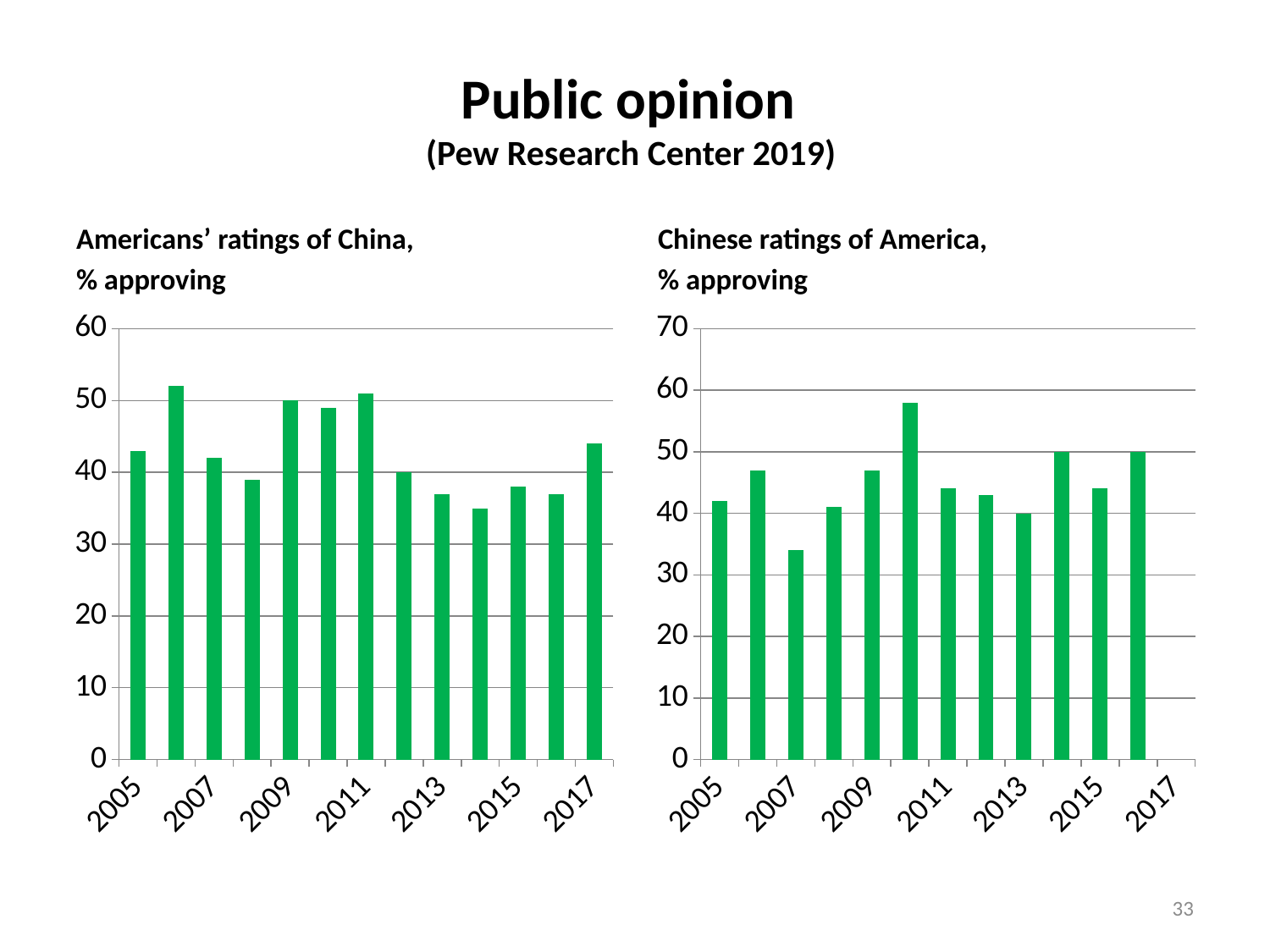
In the 'Chinese ratings of America' chart, is the value for 2010 greater or less than 50? greater In the 'Americans' ratings of China' chart, which year has the larger value, 2006 or 2014? 2006 What kind of chart is the 'Americans' ratings of China' chart? bar chart What is the highest value shown on the y axis of the 'Chinese ratings of America' chart? 70 In the 'Chinese ratings of America' chart, which year has the larger value, 2010 or 2005? 2010 In the 'Chinese ratings of America' chart, which year has the highest value? 2010 In the 'Chinese ratings of America' chart, which year has the lowest value? 2007 How many bars are plotted in the 'Americans' ratings of China' chart? 13 In the 'Americans' ratings of China' chart, is the value for 2014 greater or less than 40? less In the 'Americans' ratings of China' chart, is the value for 2006 greater or less than 50? greater In the 'Americans' ratings of China' chart, do the values rise or fall from 2011 to 2014? fall